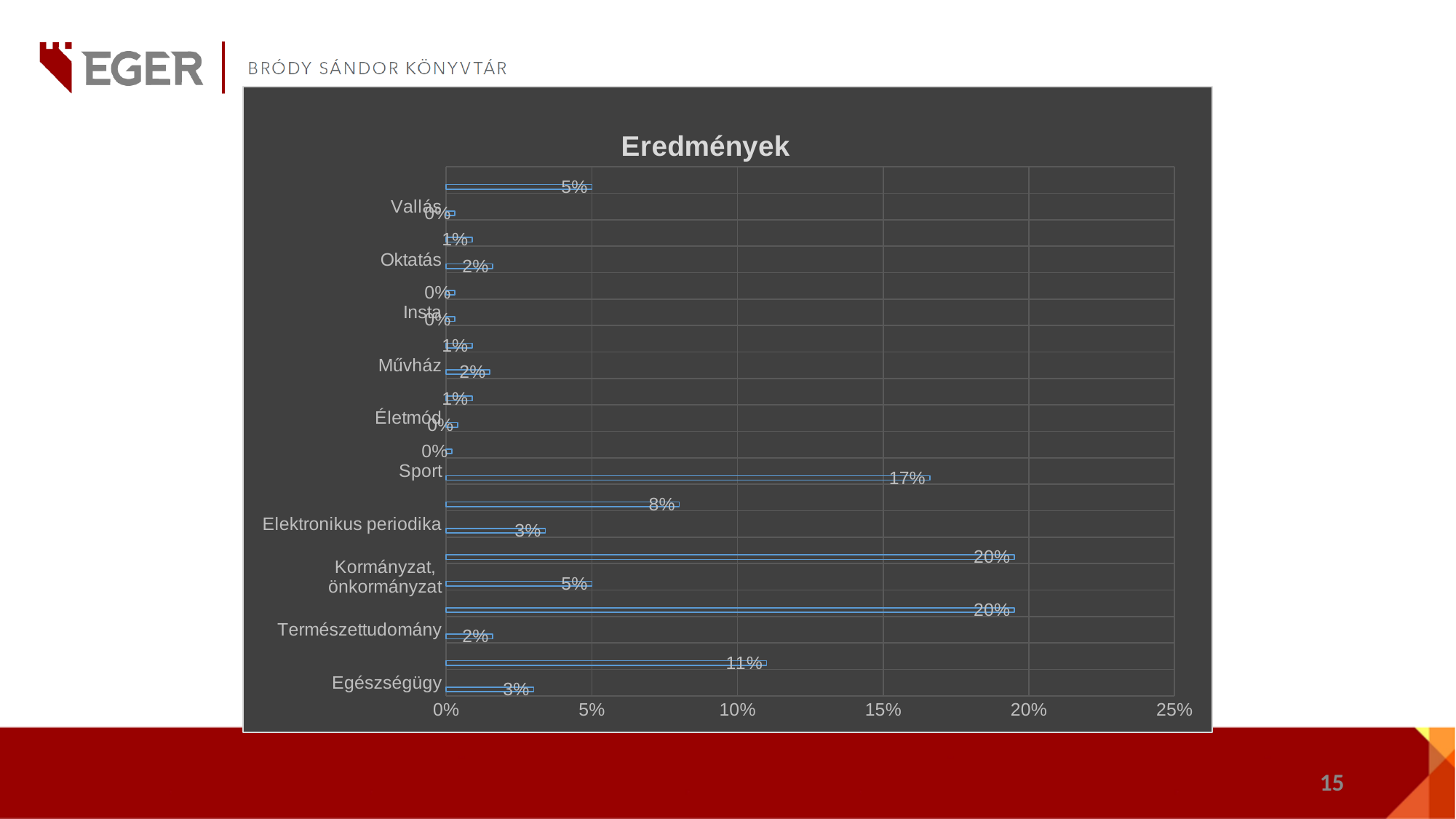
What is the lowest value shown by any bar in the chart? 0% What is the difference between the highest bar value (20%) and the bar labelled 17%? 3 percentage points What is the highest value shown by any bar in the chart? 20% How many bars in the chart are labelled 0%? 5 What is the title of the chart? Eredmények What is the value of the topmost bar in the chart? 5% What is the highest tick value shown on the horizontal axis? 25% What kind of chart is shown on the slide? bar chart How many bars in the chart are labelled 20%? 2 How many bars are plotted in the chart? 20 What is the value of the bottommost bar in the chart? 3%